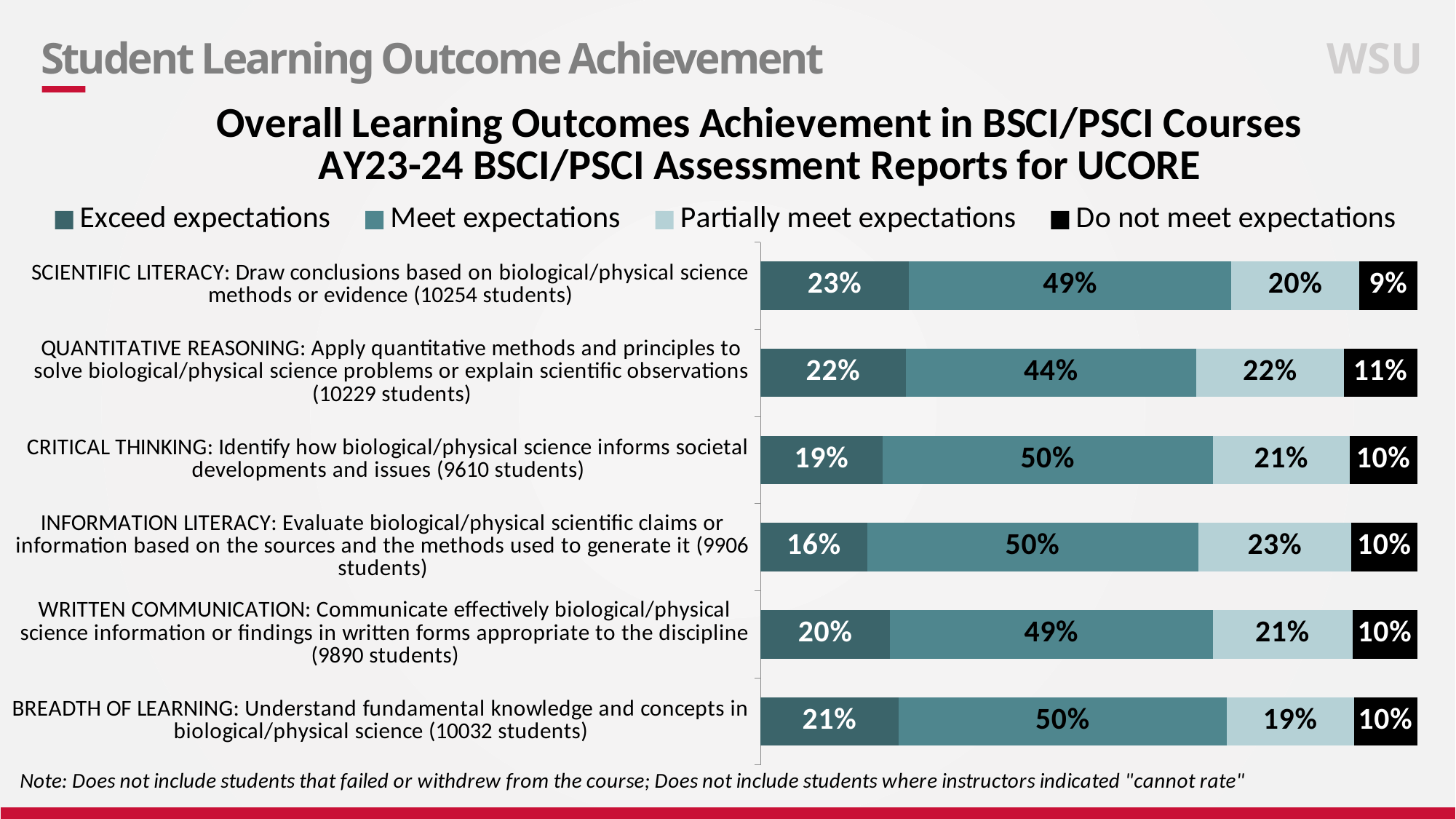
How many percentage points higher is the Meet expectations share for Critical Thinking than for Quantitative Reasoning? 6 percentage points Which learning outcome has the lowest share of students exceeding expectations? Information Literacy Which has a larger Partially meet expectations share: Information Literacy or Breadth of Learning? Information Literacy What percentage of students met expectations for Written Communication? 49% How many series does the legend list? 4 What is the total of the four segments in the Critical Thinking bar? 100% What percentage of students did not meet expectations for Quantitative Reasoning? 11% What colour represents Do not meet expectations in the chart? Black Which learning outcome has the highest share of students exceeding expectations? Scientific Literacy What kind of chart is shown on the slide? Stacked bar chart What percentage of students exceeded expectations for Scientific Literacy? 23% How many learning outcomes are shown in the chart? 6